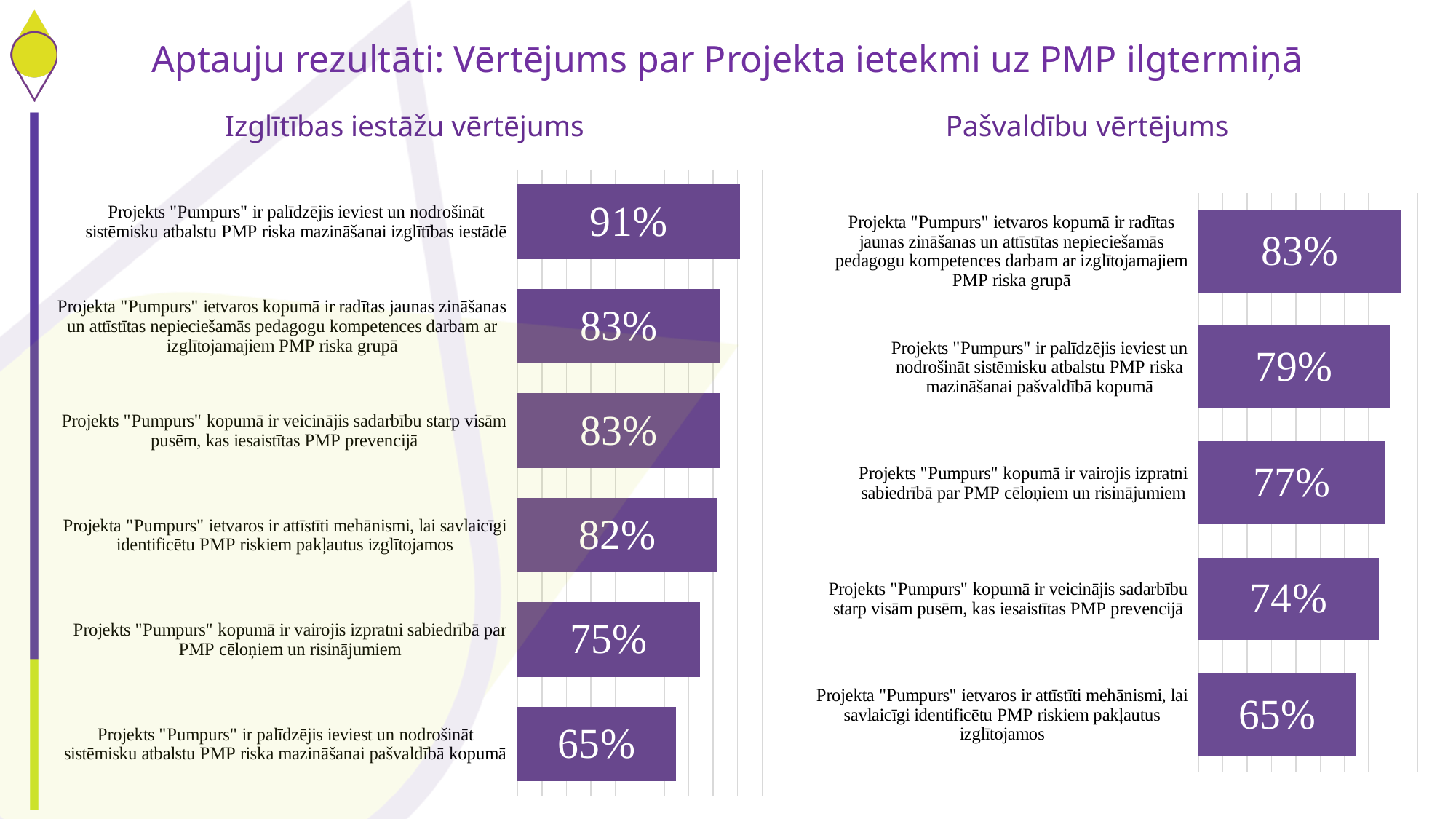
What type of chart is used for "Pašvaldību vērtējums"? Bar chart In the "Izglītības iestāžu vērtējums" chart, what is the value for "Projekts "Pumpurs" ir palīdzējis ieviest un nodrošināt sistēmisku atbalstu PMP riska mazināšanai izglītības iestādē"? 91% In the "Pašvaldību vērtējums" chart, which statement has the lowest value? Projekta "Pumpurs" ietvaros ir attīstīti mehānismi, lai savlaicīgi identificētu PMP riskiem pakļautus izglītojamos In the "Pašvaldību vērtējums" chart, what is the difference between the value for "Projekta "Pumpurs" ietvaros kopumā ir radītas jaunas zināšanas..." (83%) and "Projekts "Pumpurs" kopumā ir vairojis izpratni sabiedrībā..." (77%)? 6 percentage points In the "Pašvaldību vērtējums" chart, what is the value for "Projekts "Pumpurs" ir palīdzējis ieviest un nodrošināt sistēmisku atbalstu PMP riska mazināšanai pašvaldībā kopumā"? 79% In the "Pašvaldību vērtējums" chart, what is the value for "Projekts "Pumpurs" kopumā ir veicinājis sadarbību starp visām pusēm, kas iesaistītas PMP prevencijā"? 74% In the "Izglītības iestāžu vērtējums" chart, what is the value for "Projekts "Pumpurs" kopumā ir vairojis izpratni sabiedrībā par PMP cēloņiem un risinājumiem"? 75% Which chart gives a higher value for "Projekts "Pumpurs" kopumā ir veicinājis sadarbību starp visām pusēm, kas iesaistītas PMP prevencijā": "Izglītības iestāžu vērtējums" or "Pašvaldību vērtējums"? Izglītības iestāžu vērtējums How many bars are shown in the "Pašvaldību vērtējums" chart? 5 How many bars are shown in the "Izglītības iestāžu vērtējums" chart? 6 In the "Izglītības iestāžu vērtējums" chart, which statement has the highest value? Projekts "Pumpurs" ir palīdzējis ieviest un nodrošināt sistēmisku atbalstu PMP riska mazināšanai izglītības iestādē In the "Izglītības iestāžu vērtējums" chart, what is the difference between the highest value (91%) and the lowest value (65%)? 26 percentage points